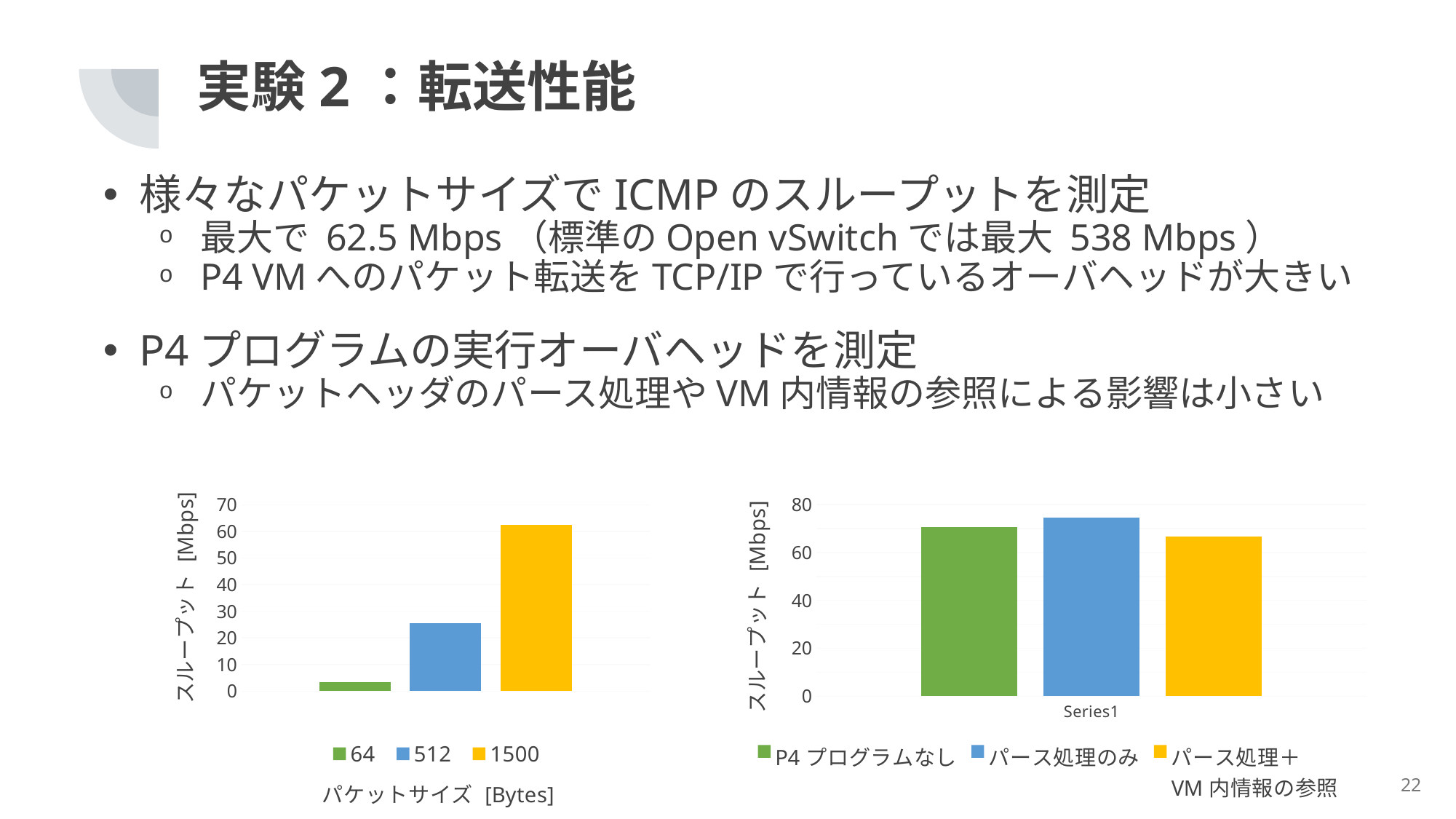
On the left chart (パケットサイズ), is the value for 64 greater or less than 10? less On the right chart (Series1), how many series does the legend list? 3 On the left chart (パケットサイズ), is the value for 1500 greater or less than 60? greater On the left chart (パケットサイズ), which packet size has the highest throughput? 1500 On the right chart (Series1), which series has the lowest throughput? パース処理＋VM内情報の参照 On the left chart (パケットサイズ), how many series does the legend list? 3 On the right chart (Series1), what is the y-axis label? スループット [Mbps] On the left chart (パケットサイズ), which packet size has the lowest throughput? 64 On the right chart (Series1), which series has the highest throughput? パース処理のみ On the left chart (パケットサイズ), what kind of chart is it? bar chart On the right chart (Series1), is the value for P4 プログラムなし greater or less than 60? greater